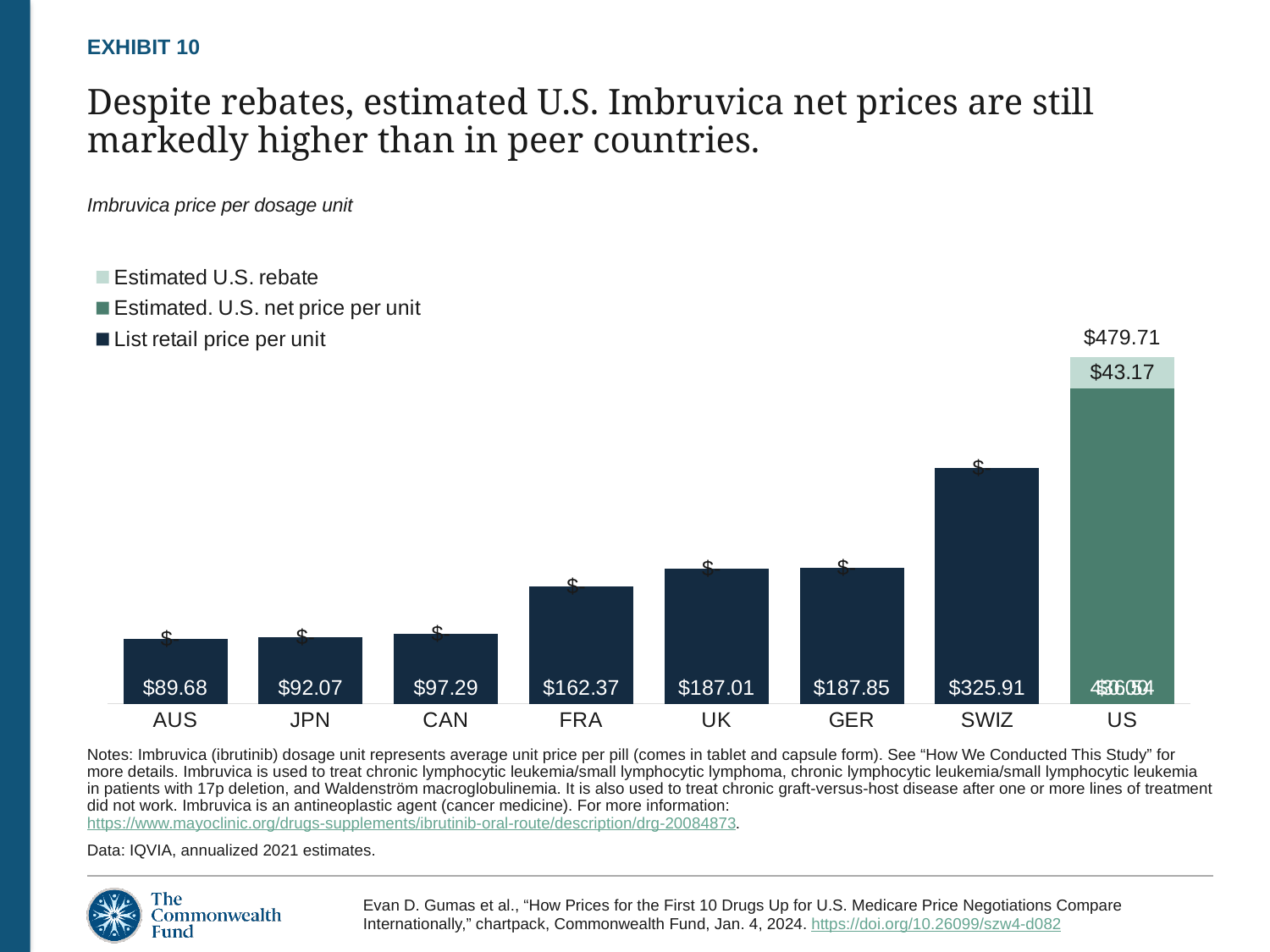
Which is larger, the price per dosage unit for UK or for CAN? UK Which country has the highest Imbruvica price per dosage unit? US What is the estimated U.S. rebate per unit shown on the US bar? $43.17 How many series does the legend list? 3 Which country has the lowest Imbruvica price per dosage unit? AUS What is the difference between the SWIZ price and the AUS price per dosage unit? $236.23 What is the Imbruvica price per dosage unit for SWIZ? $325.91 What value is printed above the US bar? $479.71 What is the Imbruvica price per dosage unit for FRA? $162.37 How many countries are shown on the x axis? 8 What kind of chart is shown on the slide? Bar chart What is the Imbruvica price per dosage unit for AUS? $89.68